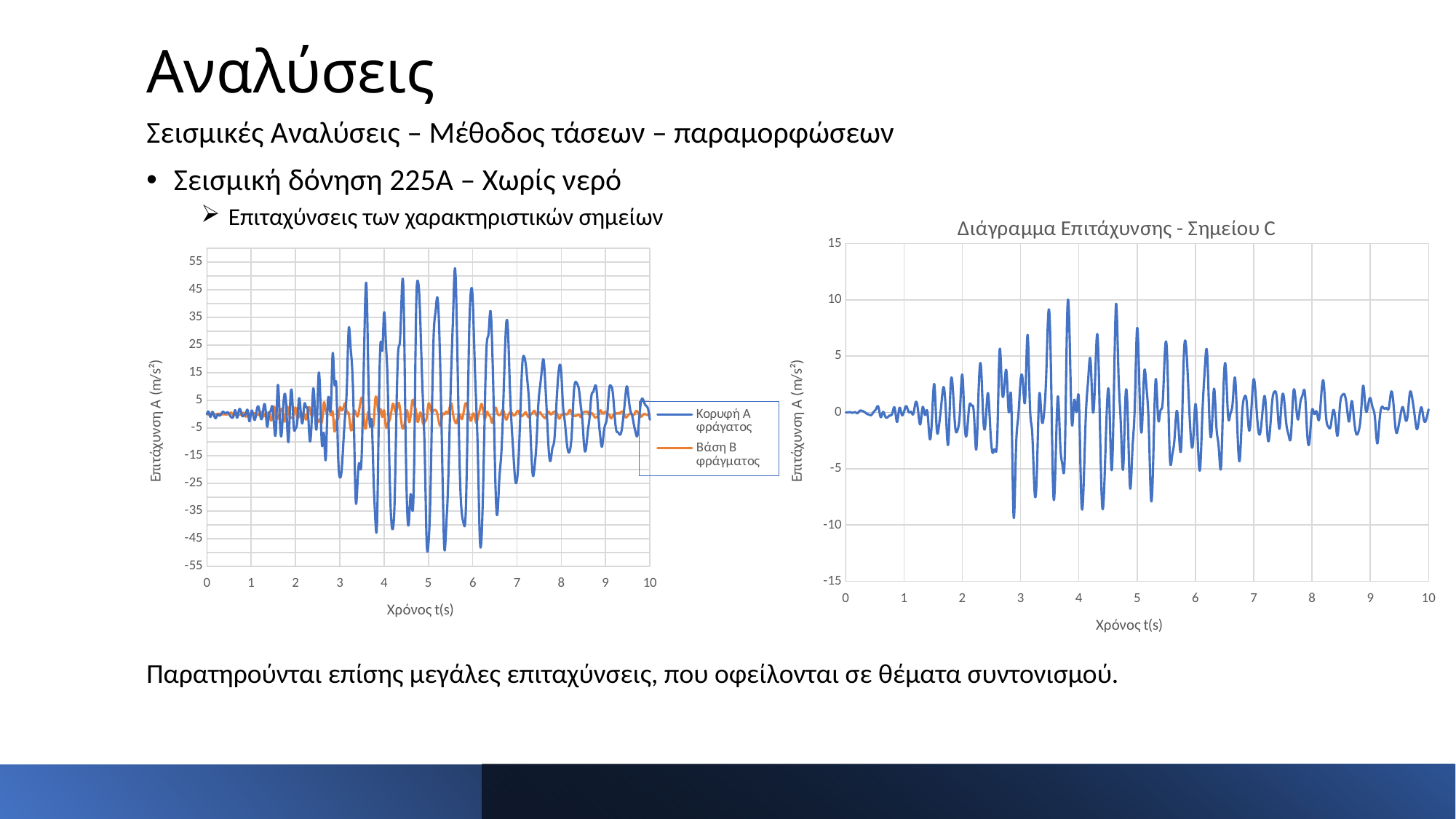
How many series does the legend of the left chart list? 2 What kind of chart is the left chart on the slide? line chart What kind of chart is the chart titled 'Διάγραμμα Επιτάχυνσης - Σημείου C'? line chart In the left chart, what colour is the line for Βάση Β φράγματος? orange In the chart titled 'Διάγραμμα Επιτάχυνσης - Σημείου C', is the highest value greater or less than 5? greater What is the title of the right chart? Διάγραμμα Επιτάχυνσης - Σημείου C In the left chart, which series reaches larger accelerations, Κορυφή Α φράγατος or Βάση Β φράγματος? Κορυφή Α φράγατος What is the x-axis label of the left chart? Χρόνος t(s) In the chart titled 'Διάγραμμα Επιτάχυνσης - Σημείου C', is the lowest value greater or less than -5? less In the left chart, is the highest value of the Κορυφή Α φράγατος series greater or less than 45? greater